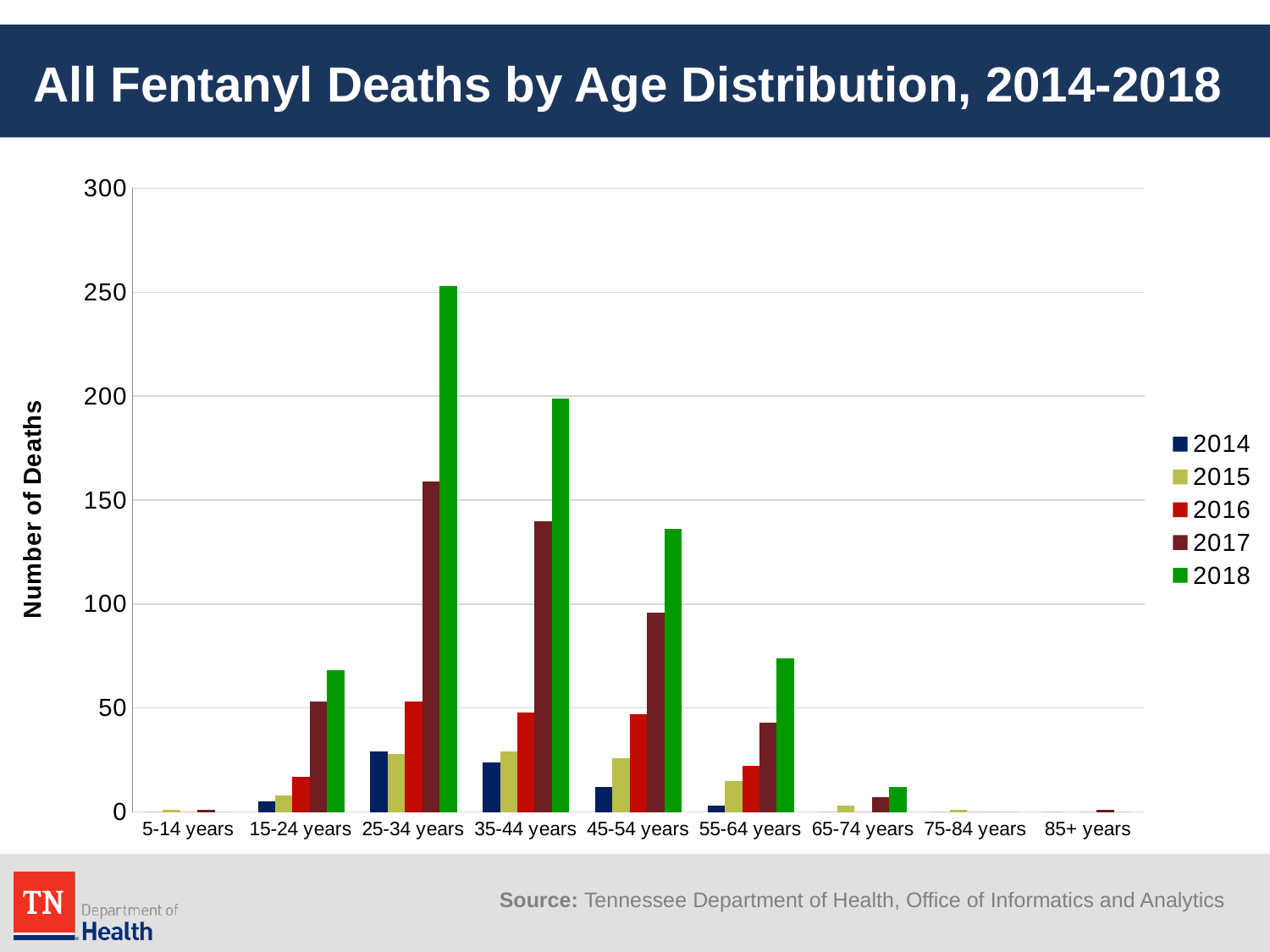
Which is larger, the 2018 value for 15-24 years or the 2018 value for 45-54 years? 45-54 years Which is larger, the 2017 value for 25-34 years or the 2017 value for 35-44 years? 25-34 years Which age group has the highest number of fentanyl deaths in 2018? 25-34 years Is the 2018 value for 55-64 years greater or less than 50? greater How many series does the legend list? 5 How many age groups are shown on the x axis? 9 For the 25-34 years age group, do the values rise or fall from 2014 to 2018? rise Is the 2018 value for 25-34 years greater or less than 200? greater What kind of chart is shown on the slide? Bar chart Is the 2018 value for 35-44 years greater or less than 150? greater What is the title of the y axis? Number of Deaths